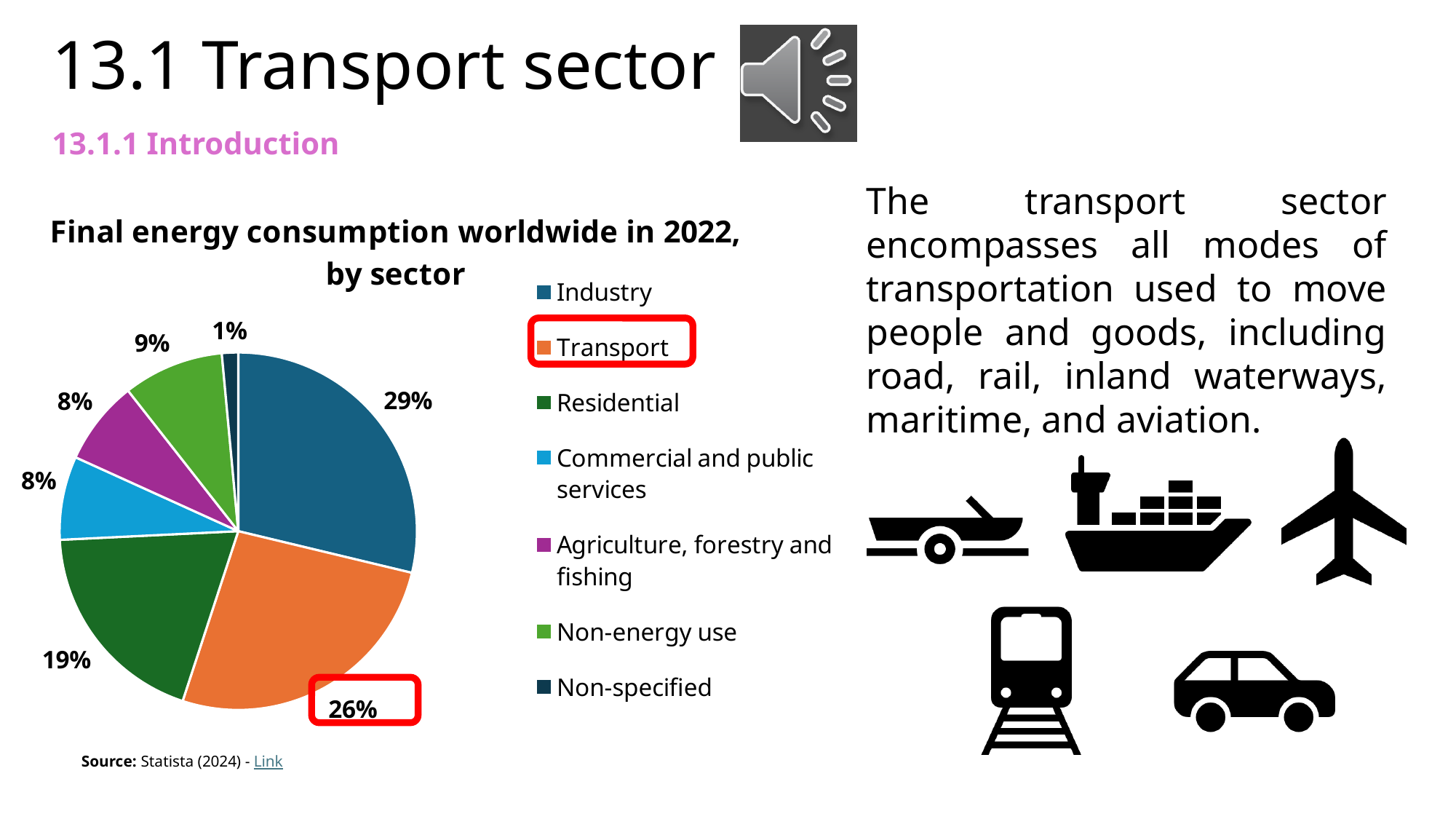
What share of final energy consumption is Non-energy use? 9% What share of final energy consumption does Industry account for? 29% What share of final energy consumption is Non-specified? 1% What share of final energy consumption does the Residential sector account for? 19% Which sector has the smallest share of final energy consumption? Non-specified Which sector has the largest share of final energy consumption? Industry What is the title of the chart? Final energy consumption worldwide in 2022, by sector How many sectors are listed in the chart legend? 7 What kind of chart is shown on the slide? Pie chart What share of final energy consumption does the Transport sector account for? 26% What is the difference in percentage points between the Industry and Transport shares? 3 percentage points Which has a larger share, Residential or Non-energy use? Residential